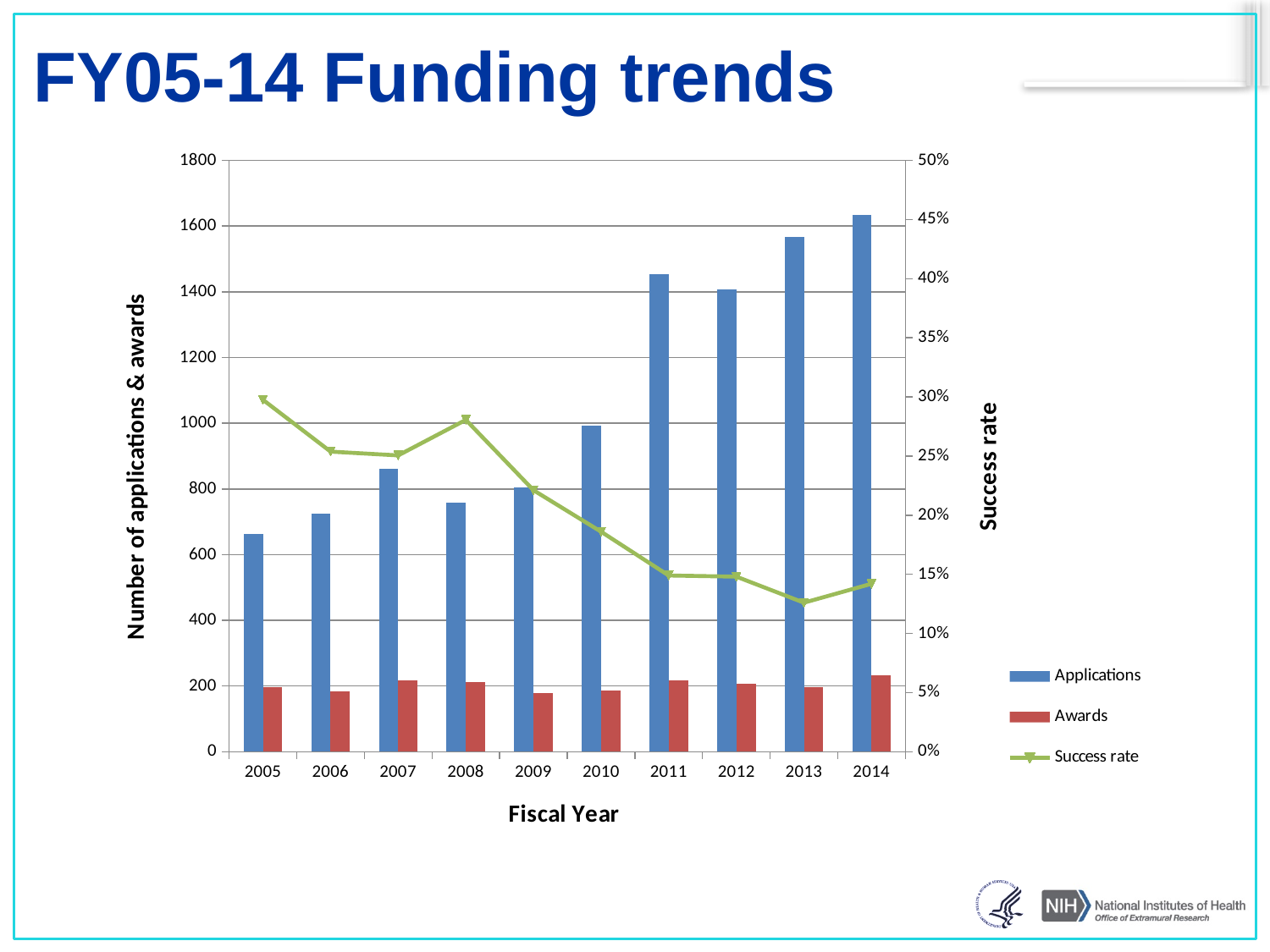
In which fiscal year is the success rate lowest? 2013 Which year had more applications, 2011 or 2012? 2011 In which fiscal year is the success rate highest? 2005 What is the overall trend of the success rate from 2005 to 2014? falling Is the success rate in 2005 greater or less than 25%? greater How many series does the legend list? 3 Which fiscal year has the highest number of applications? 2014 Is the success rate in 2013 greater or less than 15%? less How many fiscal years are shown on the x axis? 10 Is the number of applications in 2011 greater or less than 1400? greater Which fiscal year has the lowest number of applications? 2005